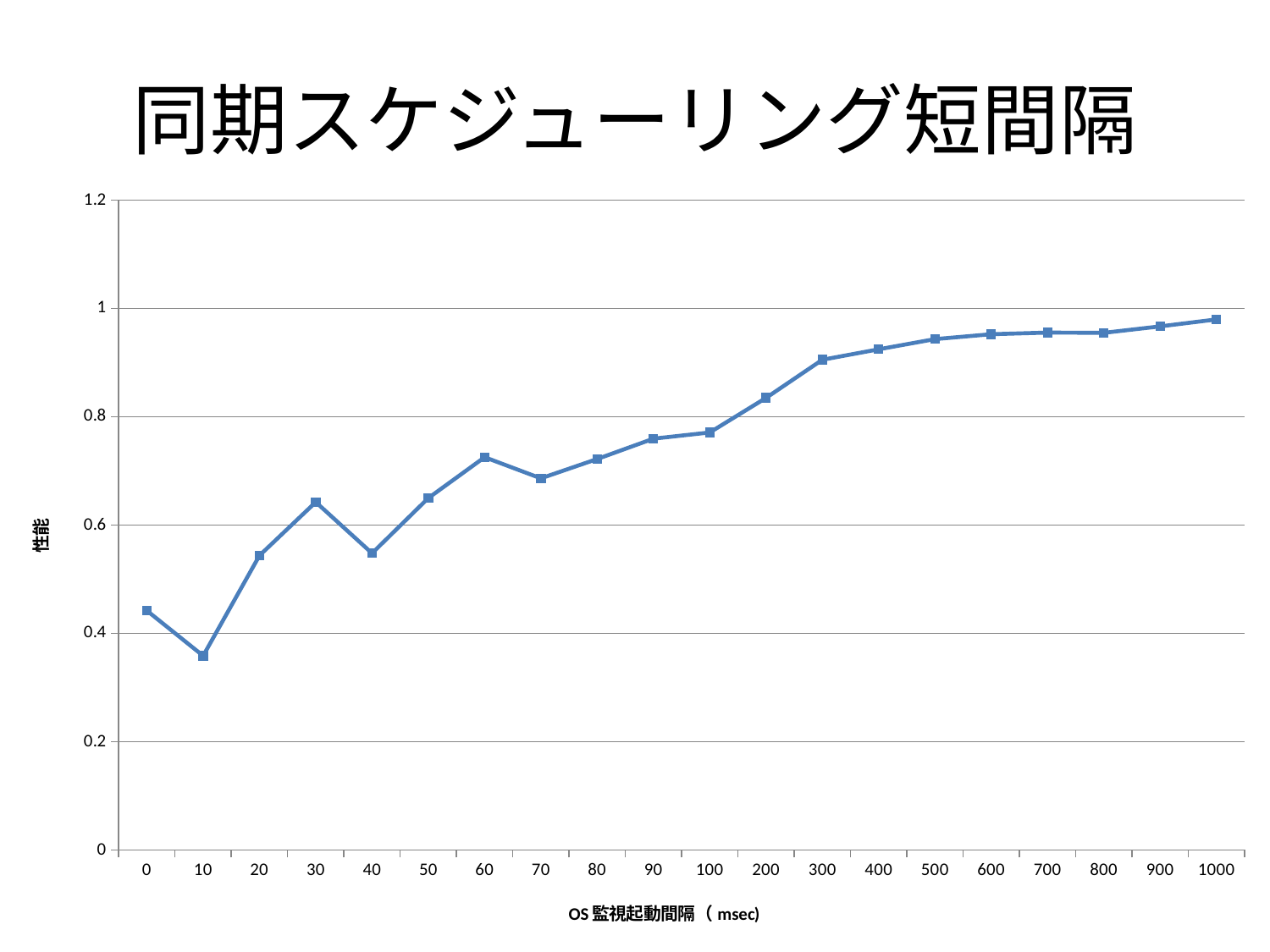
Overall, do the values rise or fall as the x-axis value increases from 0 to 1000? rise What is the label of the y axis? 性能 Which has the larger value, x = 30 or x = 40? 30 At which x-axis value is the plotted value highest? 1000 Is the value at x = 1000 greater or less than 1? less Is the value at x = 40 greater or less than 0.6? less What kind of chart is shown on the slide? line chart How many data points are plotted on the line? 20 Which has the larger value, x = 100 or x = 200? 200 Is the value at x = 10 greater or less than 0.4? less At which x-axis value is the plotted value lowest? 10